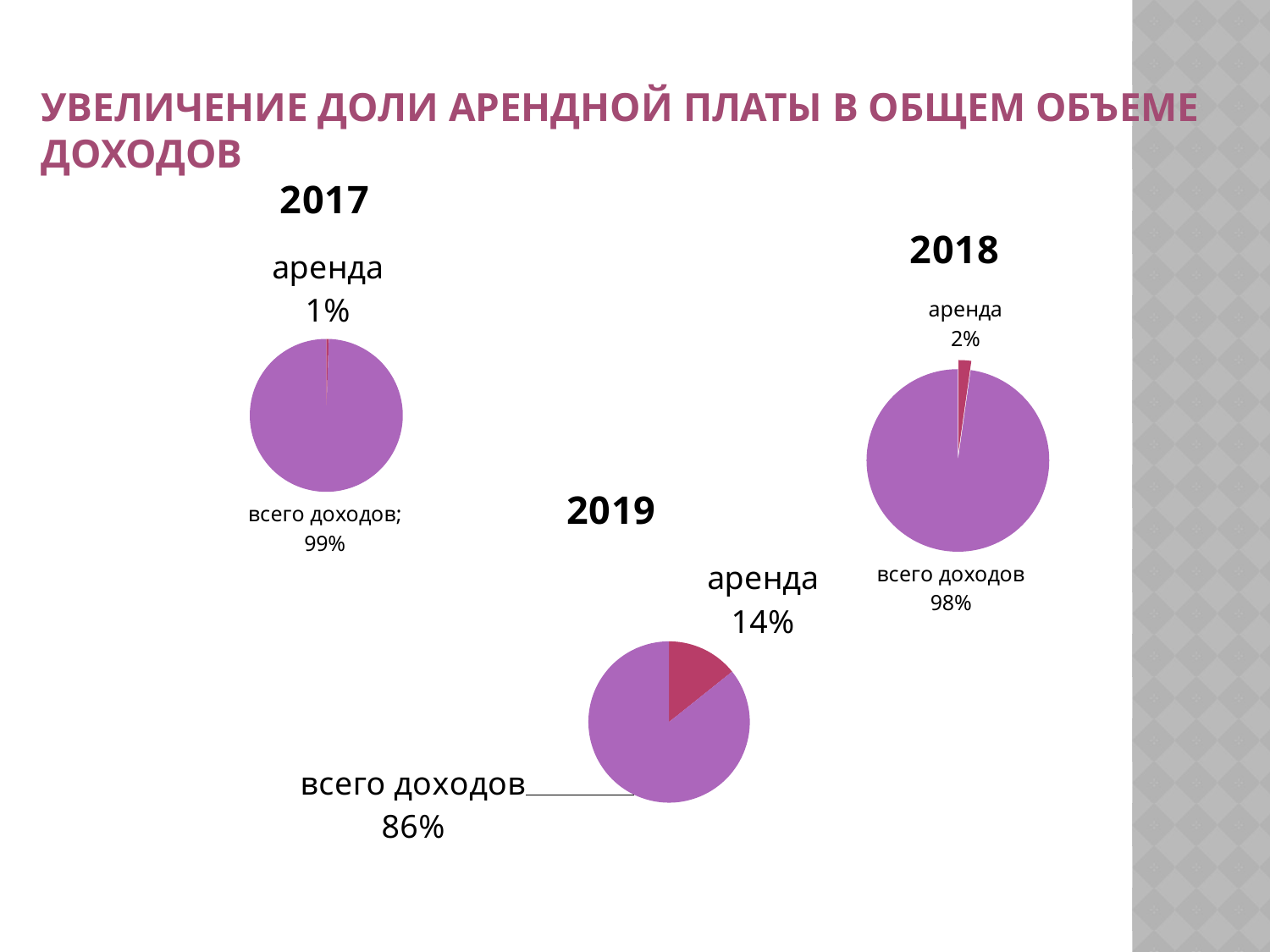
In the 2017 pie chart, what share does "аренда" have? 1% How many pie charts are on the slide? 3 In the 2018 pie chart, what share does "всего доходов" have? 98% In the 2019 pie chart, which slice is larger, "аренда" or "всего доходов"? всего доходов What is the difference between the "аренда" share in the 2019 chart and the "аренда" share in the 2017 chart? 13 percentage points Does the share of "аренда" rise or fall from the 2017 chart to the 2019 chart? Rise Which year's pie chart shows the largest share for "аренда"? 2019 In the 2019 pie chart, what share does "всего доходов" have? 86% In the 2017 pie chart, what share does "всего доходов" have? 99% In the 2019 pie chart, what share does "аренда" have? 14% In the 2018 pie chart, what share does "аренда" have? 2% What kind of chart is used for each year on the slide? Pie chart